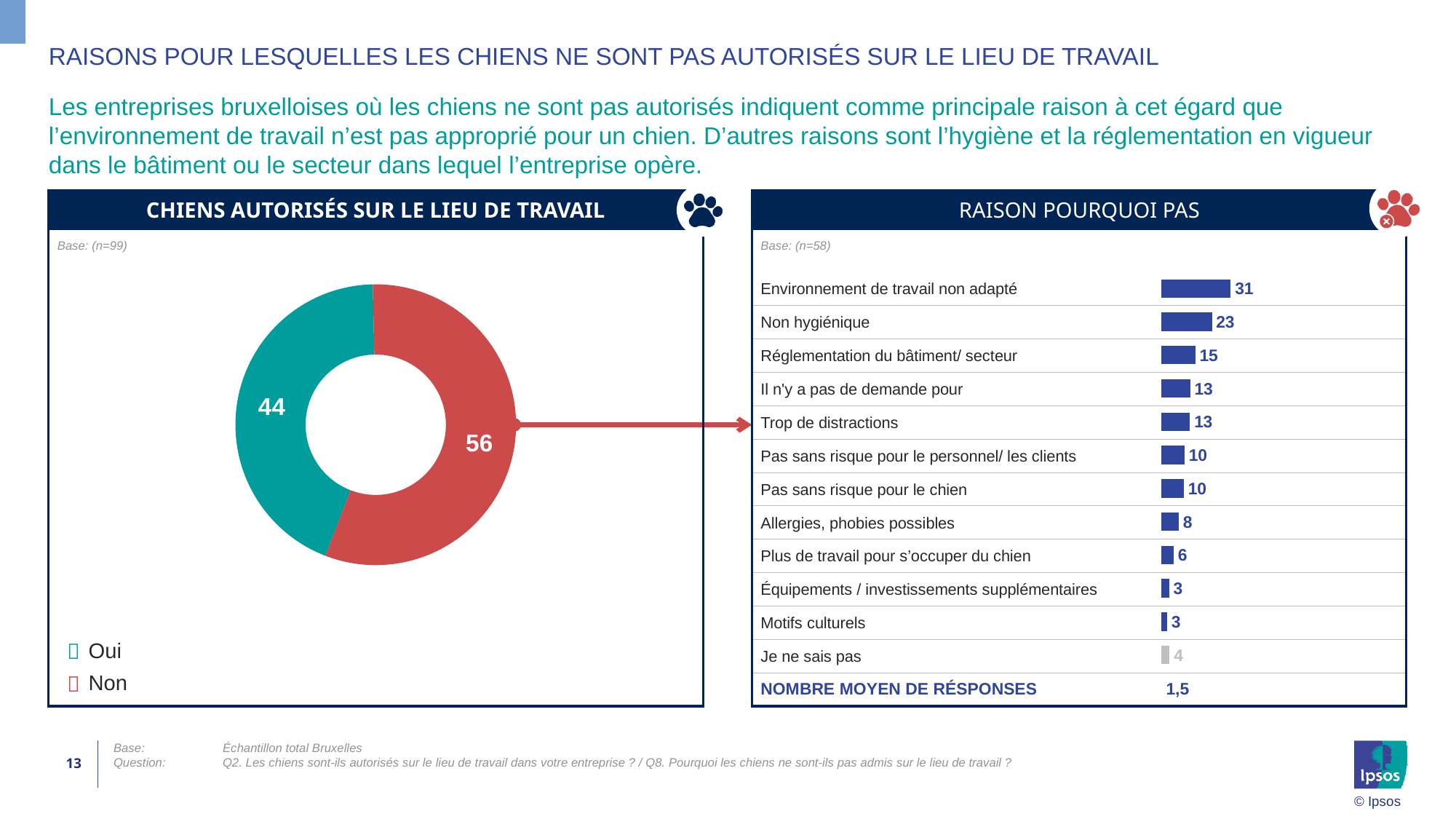
In the 'CHIENS AUTORISÉS SUR LE LIEU DE TRAVAIL' chart, what is the value for 'Non'? 56 In the 'RAISON POURQUOI PAS' chart, what is the 'NOMBRE MOYEN DE RÉSPONSES'? 1,5 In the 'RAISON POURQUOI PAS' chart, what is the value for 'Réglementation du bâtiment/ secteur'? 15 What kind of chart is 'CHIENS AUTORISÉS SUR LE LIEU DE TRAVAIL'? Donut (pie) chart In the 'CHIENS AUTORISÉS SUR LE LIEU DE TRAVAIL' chart, which is larger, 'Oui' or 'Non'? Non In the 'RAISON POURQUOI PAS' chart, what is the difference between 'Environnement de travail non adapté' and 'Non hygiénique'? 8 In the 'RAISON POURQUOI PAS' chart, how many reason categories are listed (excluding the average number of responses row)? 12 In the 'RAISON POURQUOI PAS' chart, which reason has the highest value? Environnement de travail non adapté In the 'CHIENS AUTORISÉS SUR LE LIEU DE TRAVAIL' chart, what is the difference between 'Non' and 'Oui'? 12 In the 'RAISON POURQUOI PAS' chart, what is the value for 'Non hygiénique'? 23 In the 'CHIENS AUTORISÉS SUR LE LIEU DE TRAVAIL' chart, what is the value for 'Oui'? 44 What kind of chart is 'RAISON POURQUOI PAS'? Bar chart